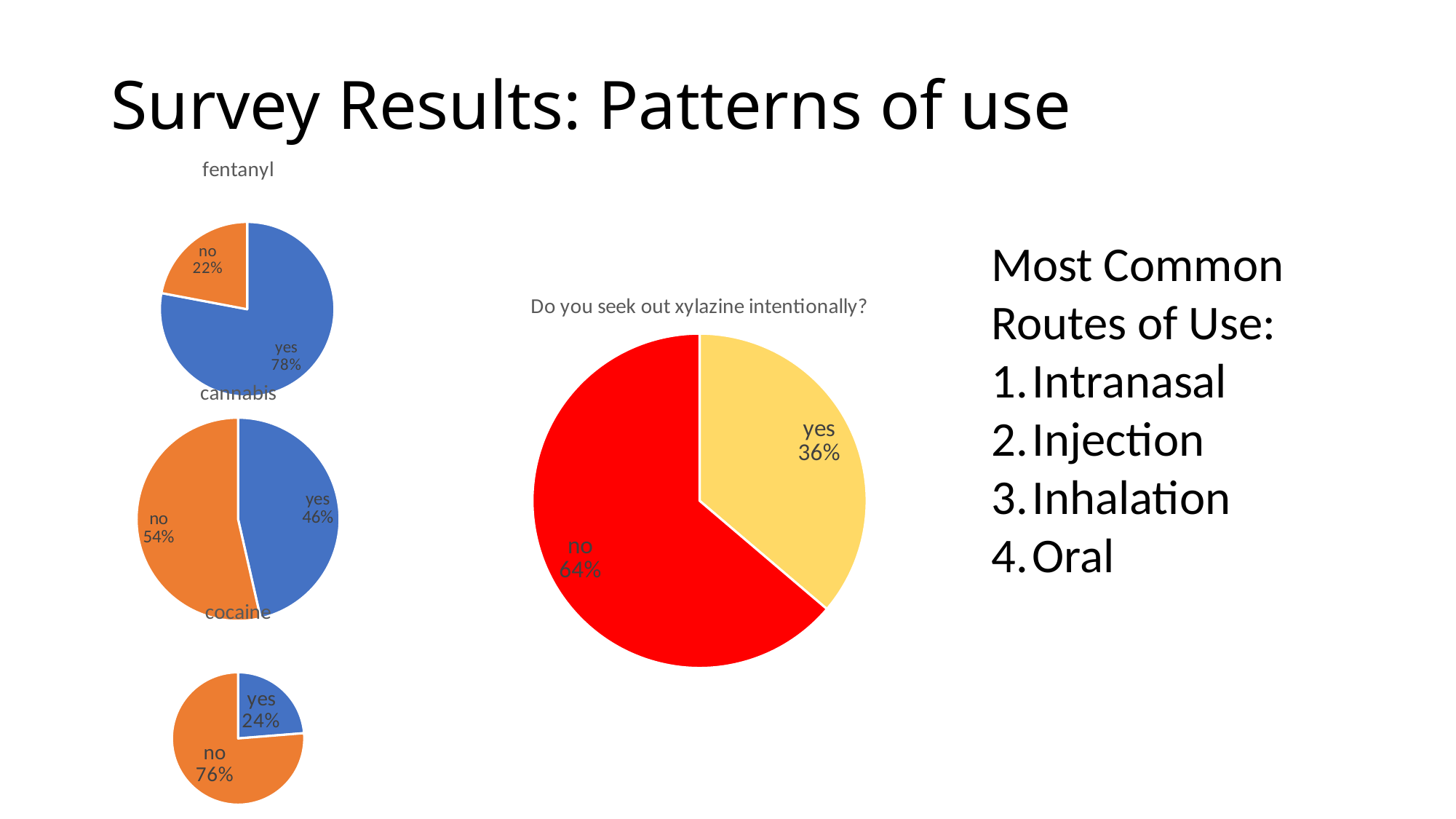
In the fentanyl pie chart, which slice is the largest? yes In the fentanyl pie chart, what percentage answered no? 22% In the chart titled 'Do you seek out xylazine intentionally?', what percentage answered yes? 36% In the cocaine pie chart, what percentage answered yes? 24% In the cocaine pie chart, which slice is larger, yes or no? no In the chart titled 'Do you seek out xylazine intentionally?', what is the difference between the no and yes percentages? 28% In the cannabis pie chart, what is the difference between the no and yes percentages? 8% What type of chart is used for the 'Do you seek out xylazine intentionally?' chart? pie chart In the cannabis pie chart, what percentage answered no? 54% In the fentanyl pie chart, what percentage answered yes? 78% How many slices does the cannabis pie chart have? 2 In the chart titled 'Do you seek out xylazine intentionally?', what percentage answered no? 64%